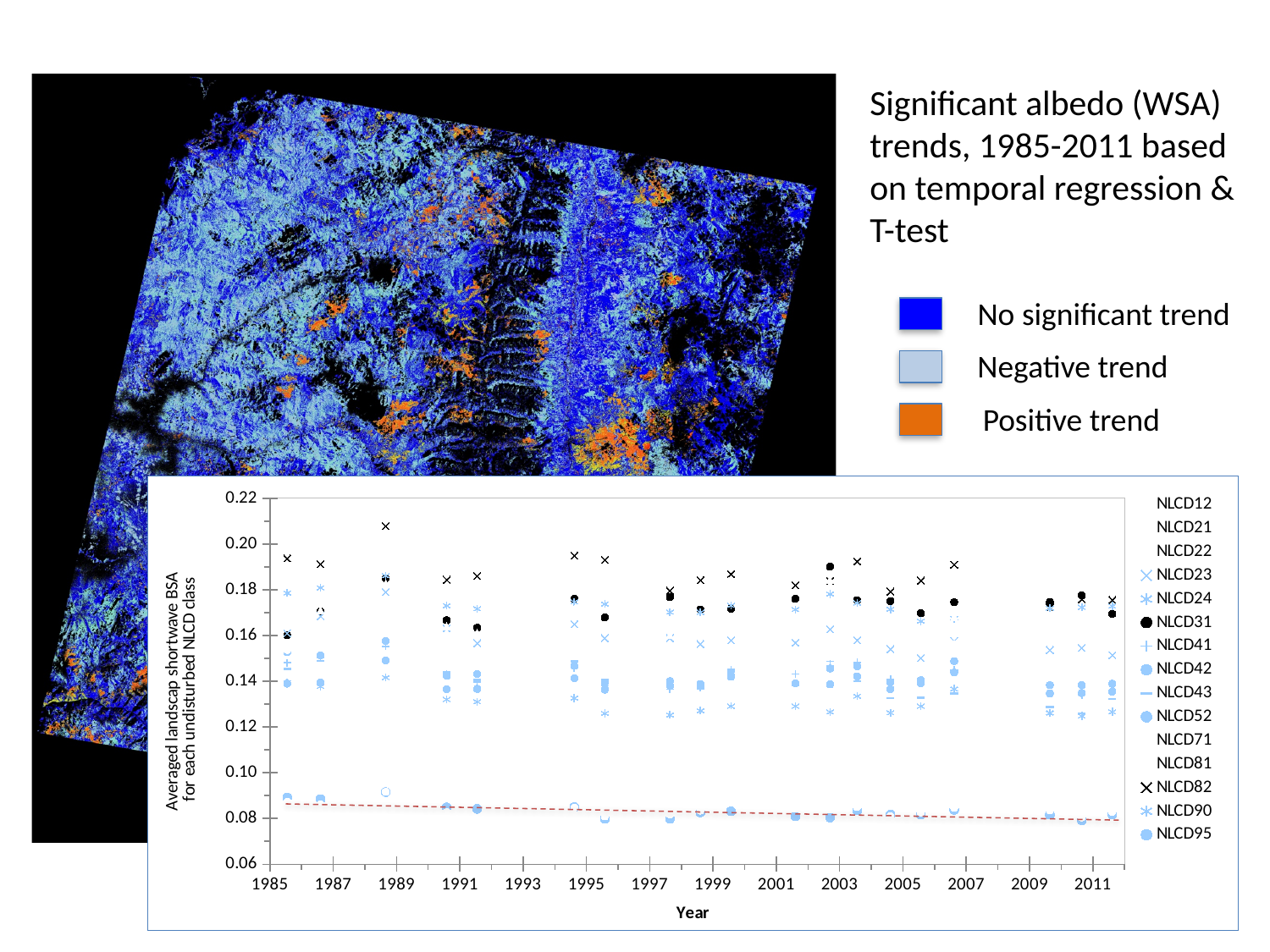
What is the last year labelled on the x axis of the scatter chart? 2011 What is the title of the x axis of the scatter chart? Year In the scatter chart, is the value for NLCD31 around 1991 greater or less than 0.18? less In the scatter chart, is the value for NLCD82 around 2011 greater or less than 0.20? less In the scatter chart, is the value for NLCD82 around 1988 greater or less than 0.20? greater What kind of chart is shown at the bottom of the slide? scatter chart Which series reaches the highest value anywhere in the scatter chart? NLCD82 What is the title of the y axis of the scatter chart? Averaged landscap shortwave BSA for each undisturbed NLCD class Does the red dashed trend line in the scatter chart rise or fall from 1985 to 2011? fall How many series does the legend of the scatter chart list? 15 What is the highest tick value shown on the y axis of the scatter chart? 0.22